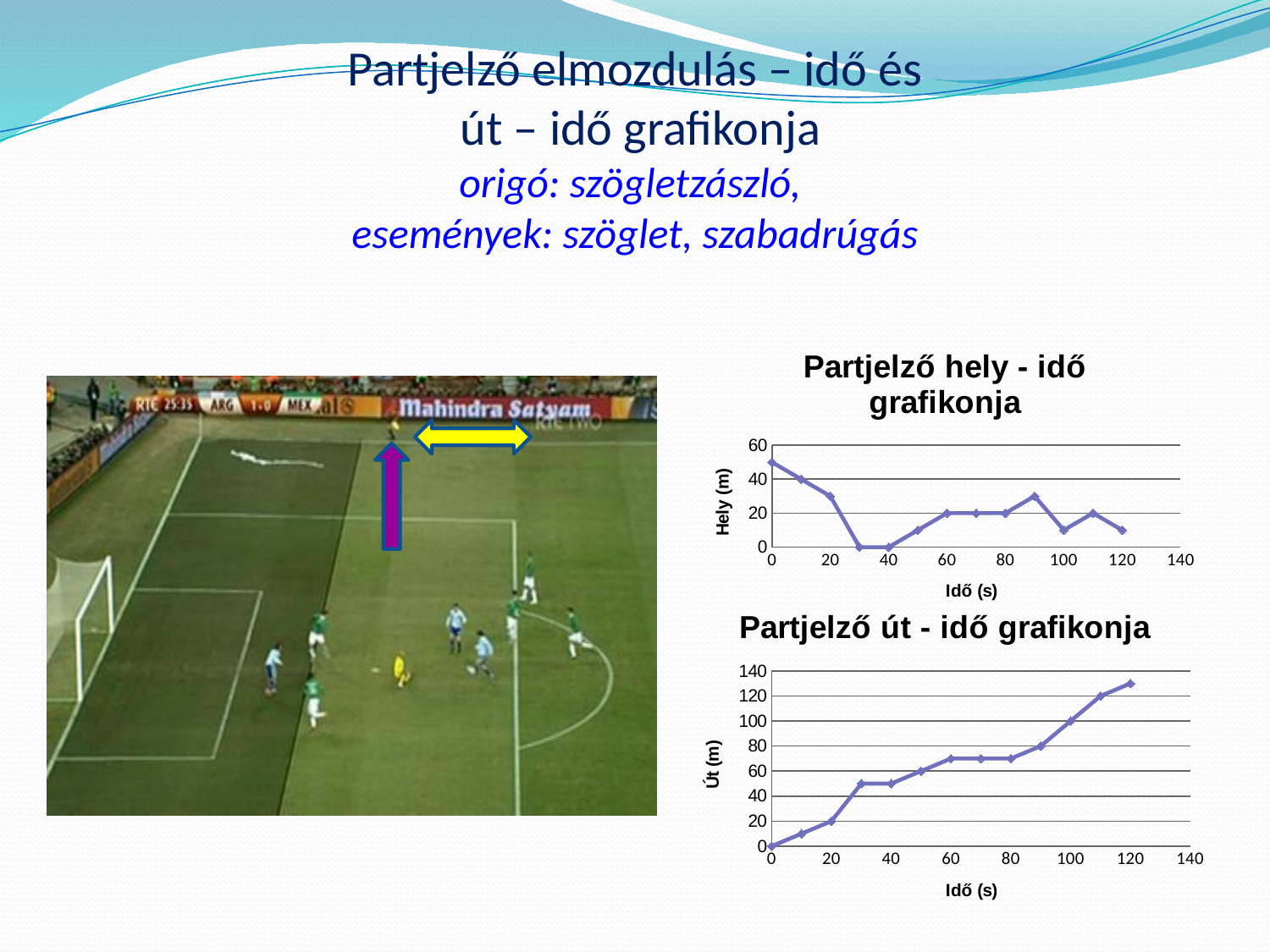
In the 'Partjelző út - idő grafikonja' chart, is the value at 120 s greater or less than 120? greater In the 'Partjelző hely - idő grafikonja' chart, at which time is the Hely value highest? 0 s In the 'Partjelző út - idő grafikonja' chart, which is larger: the value at 100 s or the value at 50 s? 100 s In the 'Partjelző út - idő grafikonja' chart, what is the Út (m) value at 110 s? 120 What is the x-axis label of the 'Partjelző út - idő grafikonja' chart? Idő (s) In the 'Partjelző hely - idő grafikonja' chart, what is the Hely (m) value at 30 s? 0 In the 'Partjelző hely - idő grafikonja' chart, how many data points are plotted? 13 In the 'Partjelző út - idő grafikonja' chart, what is the Út (m) value at 100 s? 100 In the 'Partjelző hely - idő grafikonja' chart, is the value at 90 s greater or less than 20? greater In the 'Partjelző út - idő grafikonja' chart, do the values generally rise or fall as time increases? rise What kind of chart is the 'Partjelző hely - idő grafikonja' chart? line chart In the 'Partjelző hely - idő grafikonja' chart, what is the Hely (m) value at 60 s? 20